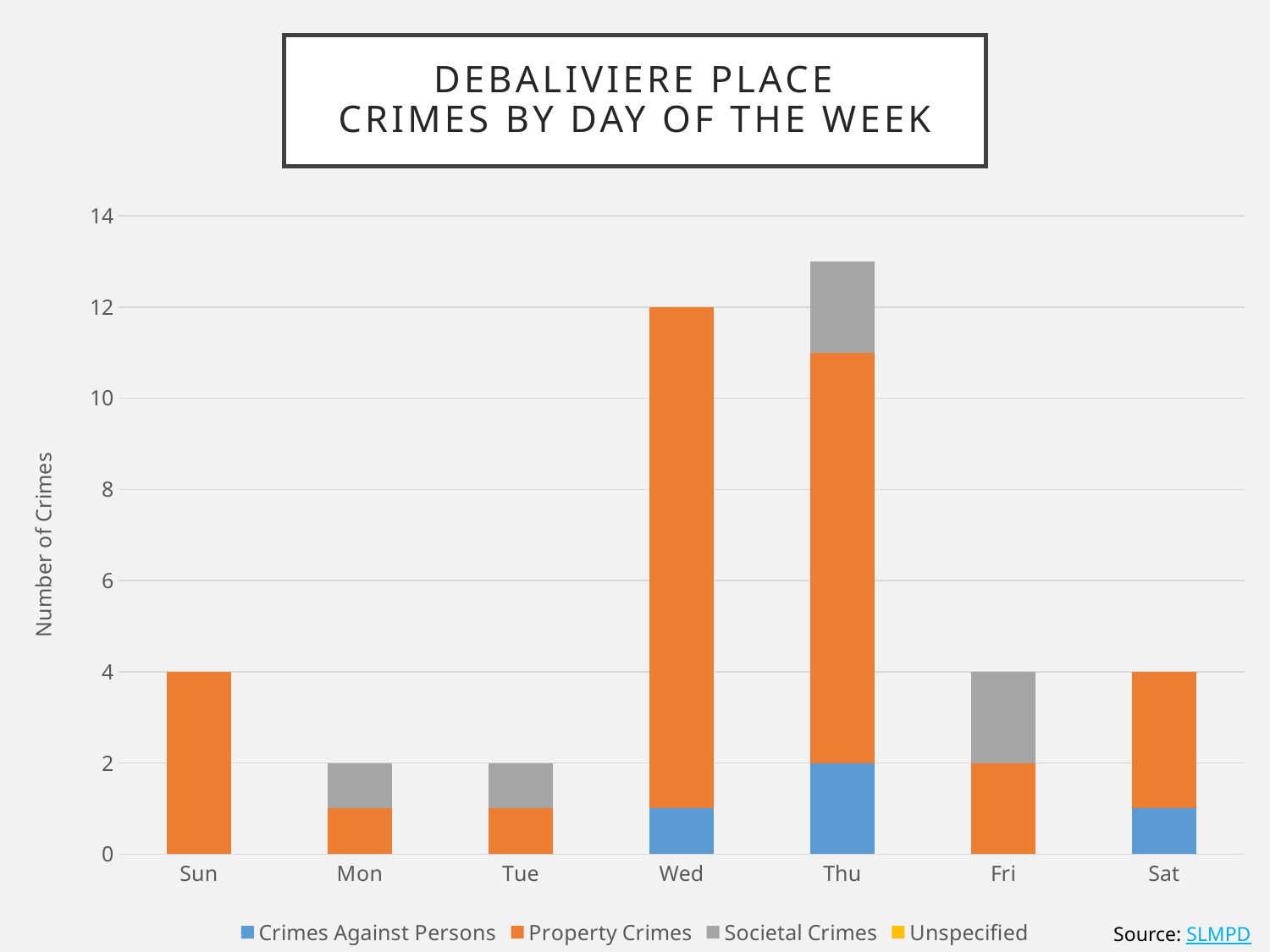
How many days of the week are shown on the x axis? 7 Which day has more total crimes, Wed or Sat? Wed Is the total number of crimes on Thu greater or less than 12? greater What is the label of the y axis? Number of Crimes Which day has the highest total number of crimes? Thu What is the total number of crimes on Wed? 12 What type of chart is shown on the slide? Stacked bar chart What is the title of the chart? DEBALIVIERE PLACE CRIMES BY DAY OF THE WEEK What is the total number of crimes on Mon? 2 What is the total number of crimes on Sun? 4 Which series is shown in orange in the legend? Property Crimes How many series does the legend list? 4